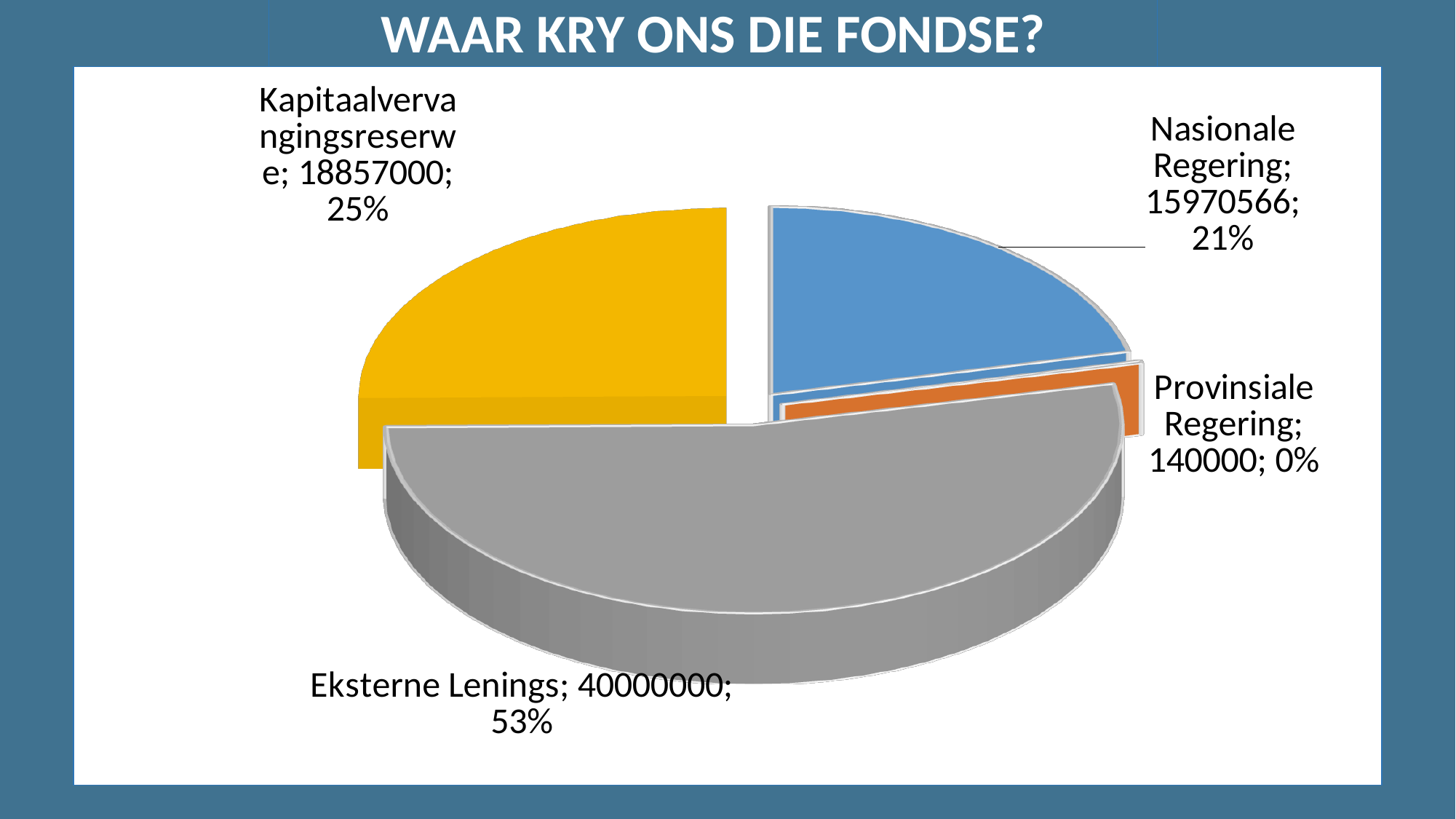
Which category has the largest slice of the pie? Eksterne Lenings Which category has the smallest slice of the pie? Provinsiale Regering What is the value for Eksterne Lenings? 40000000 What is the value for Kapitaalvervangingsreserwe? 18857000 What share of the pie does Eksterne Lenings represent? 53% Which is larger, Kapitaalvervangingsreserwe or Nasionale Regering? Kapitaalvervangingsreserwe How many slices does the pie chart have? 4 What is the difference between the values for Eksterne Lenings and Kapitaalvervangingsreserwe? 21143000 What share of the pie does Nasionale Regering represent? 21% What is the value for Provinsiale Regering? 140000 What is the value for Nasionale Regering? 15970566 What kind of chart is shown on the slide? pie chart